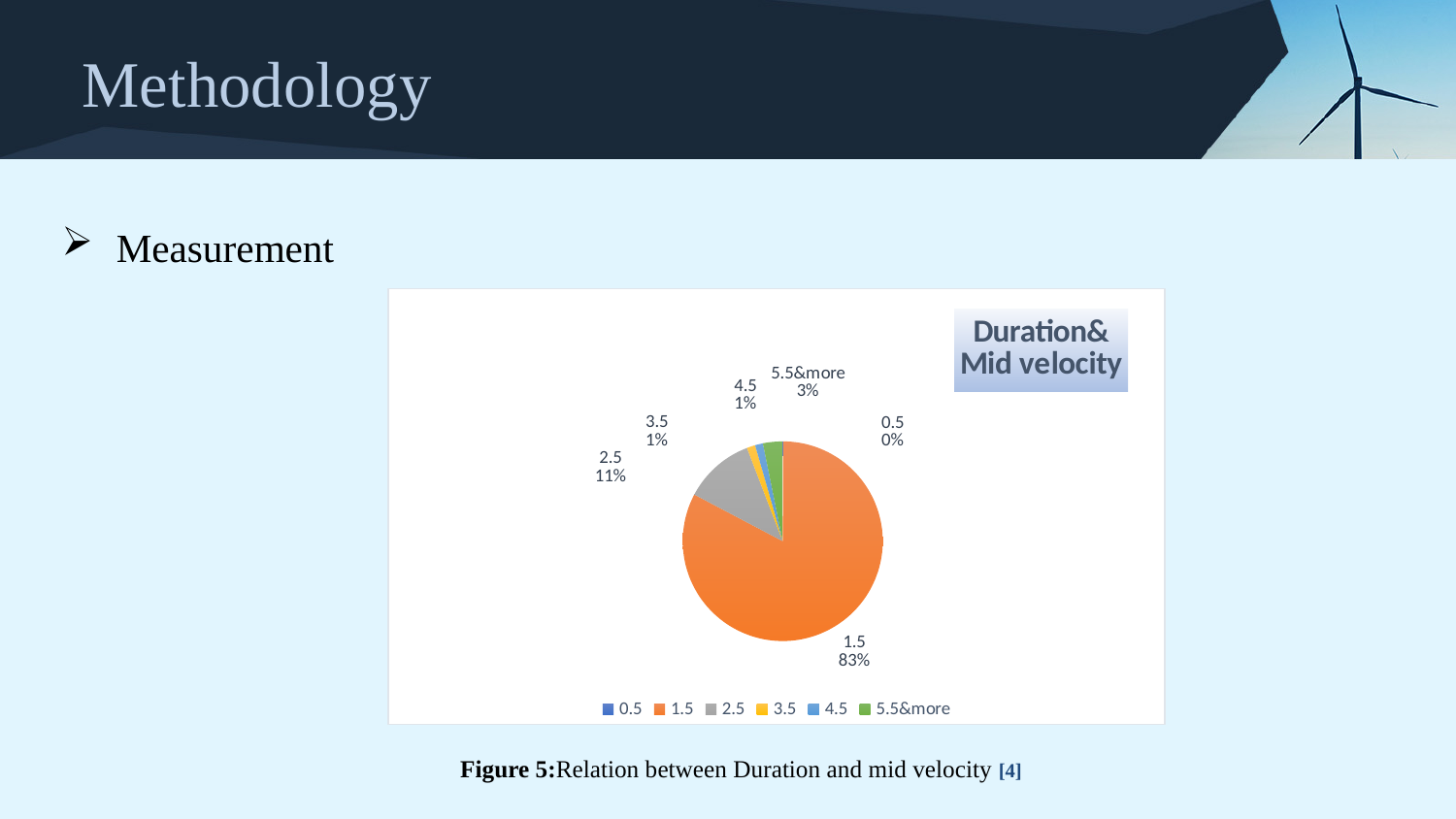
What share of the pie does the 1.5 slice represent? 83% Which slice is larger, 2.5 or 5.5&more? 2.5 What percentage is shown for the 5.5&more slice? 3% How many categories does the legend list? 6 Which category has the largest slice of the pie? 1.5 What is the difference in percentage points between the 1.5 slice and the 2.5 slice? 72 What kind of chart is shown on the slide? pie chart What is the title of the chart? Duration& Mid velocity Which category has the smallest slice of the pie? 0.5 What percentage is shown for the 0.5 slice? 0% What percentage is shown for the 3.5 slice? 1% What share of the pie does the 2.5 slice represent? 11%